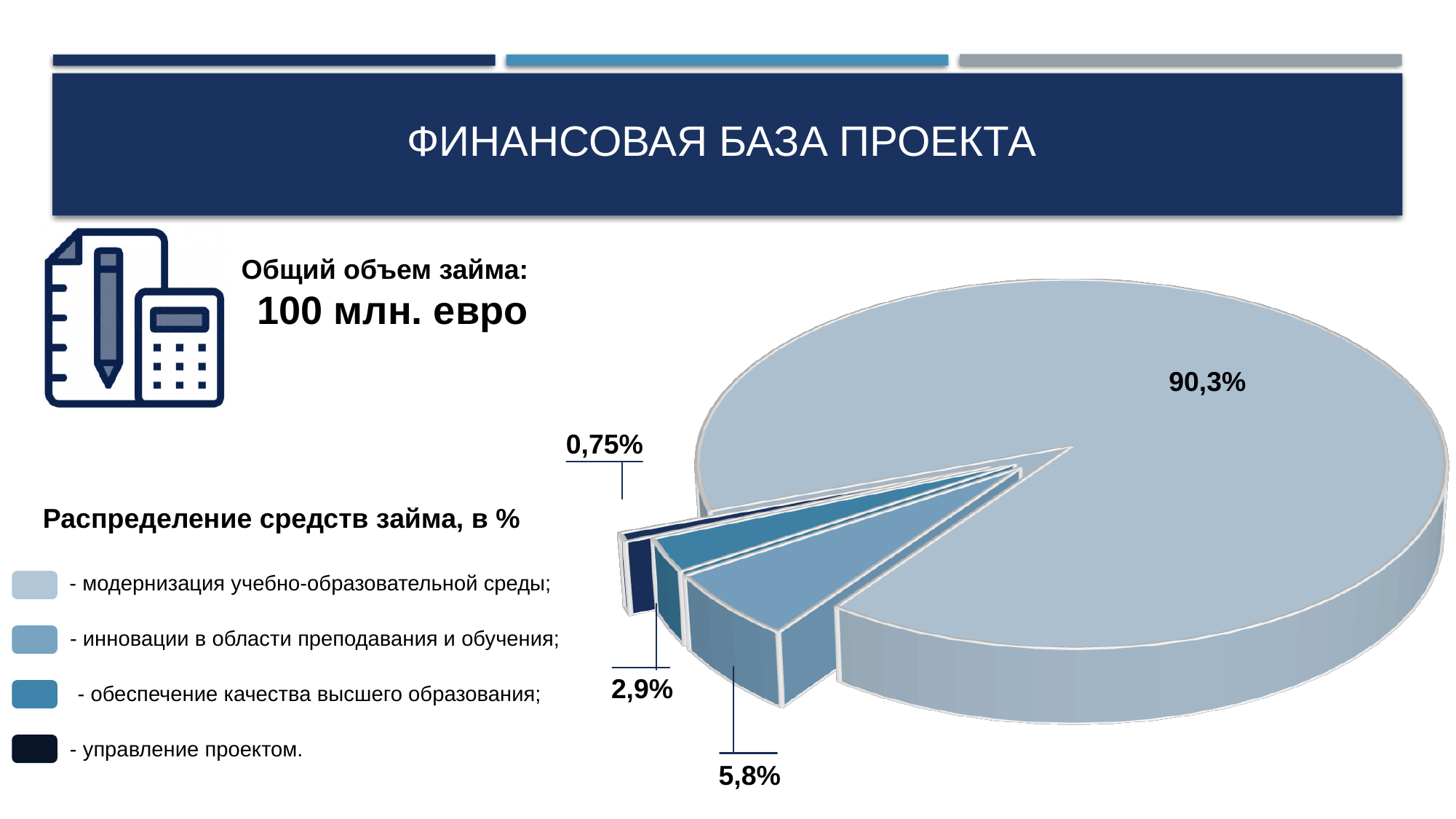
What share of the loan funds goes to модернизация учебно-образовательной среды? 90,3% What is the total loan amount stated on the slide? 100 млн. евро What kind of chart is shown on the slide? pie chart What share of the loan funds goes to управление проектом? 0,75% What share of the loan funds goes to обеспечение качества высшего образования? 2,9% How many slices does the pie chart have? 4 What share of the loan funds goes to инновации в области преподавания и обучения? 5,8% Which is larger: the share for инновации в области преподавания и обучения or the share for обеспечение качества высшего образования? инновации в области преподавания и обучения What is the difference between the share for инновации в области преподавания и обучения and the share for обеспечение качества высшего образования? 2,9% What is the difference between the share for обеспечение качества высшего образования and the share for управление проектом? 2,15% Which category has the largest share of the pie? модернизация учебно-образовательной среды Which category has the smallest share of the pie? управление проектом